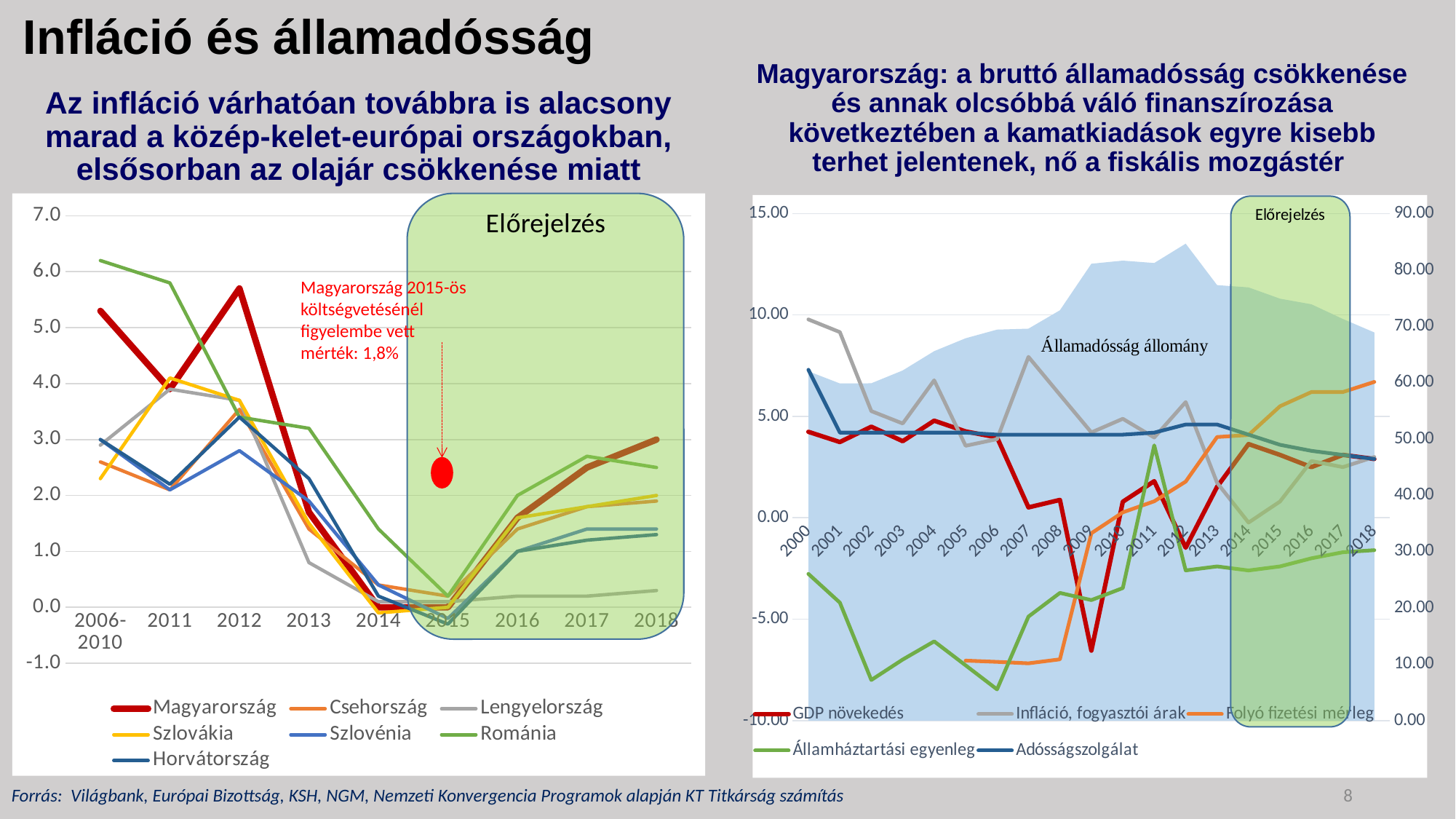
In the left chart, which is larger in 2018: Magyarország or Lengyelország? Magyarország In the right chart, is the value for Adósságszolgálat in 2000 greater or less than 5.00? greater In the left chart, is the value for Magyarország in 2012 greater or less than 5.0? greater How many series does the legend of the left chart list? 7 In the left chart, which country has the lowest value in 2018? Lengyelország In the left chart, which country has the highest value in 2012? Magyarország How many series does the legend of the right chart list? 5 What type of chart is the left chart on the slide? line chart How many x-axis categories does the left chart show? 9 In the right chart, is the value for GDP növekedés in 2009 greater or less than -5.00? less In the left chart, does the Magyarország line rise or fall from 2012 to 2015? fall